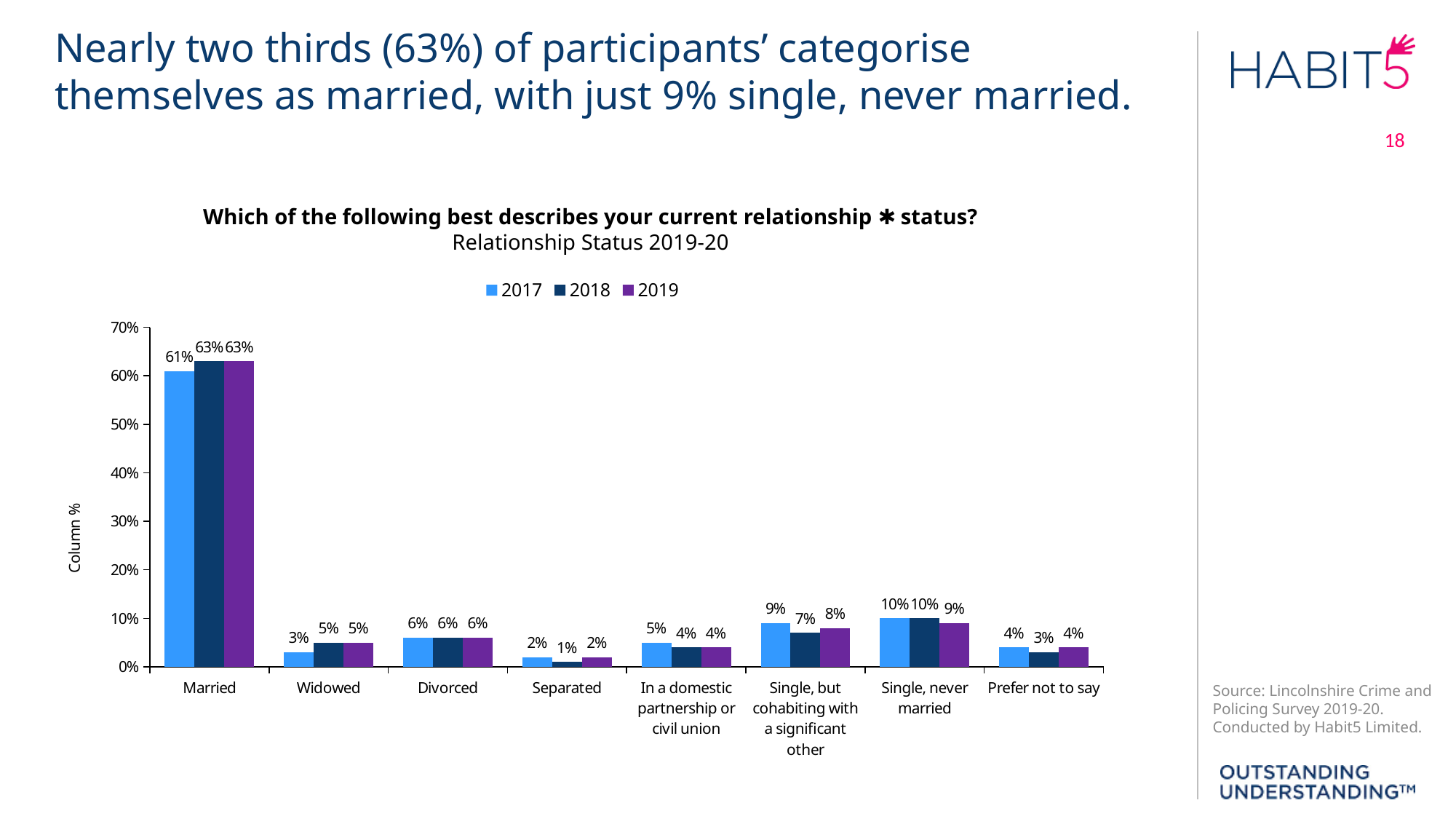
What is the difference between the 2018 and 2017 values for Married? 2% What is the 2017 value for Widowed? 3% Which category has the lowest value in 2018? Separated What is the 2018 value for Single, but cohabiting with a significant other? 7% Which is larger, the 2017 value for In a domestic partnership or civil union or the 2019 value for In a domestic partnership or civil union? 2017 What is the 2019 value for Single, never married? 9% What kind of chart is shown? Bar chart How many series does the legend list? 3 What is the 2019 value for Married? 63% What is the label on the vertical axis? Column % Which category has the highest value in 2017? Married How many categories are shown on the x axis? 8